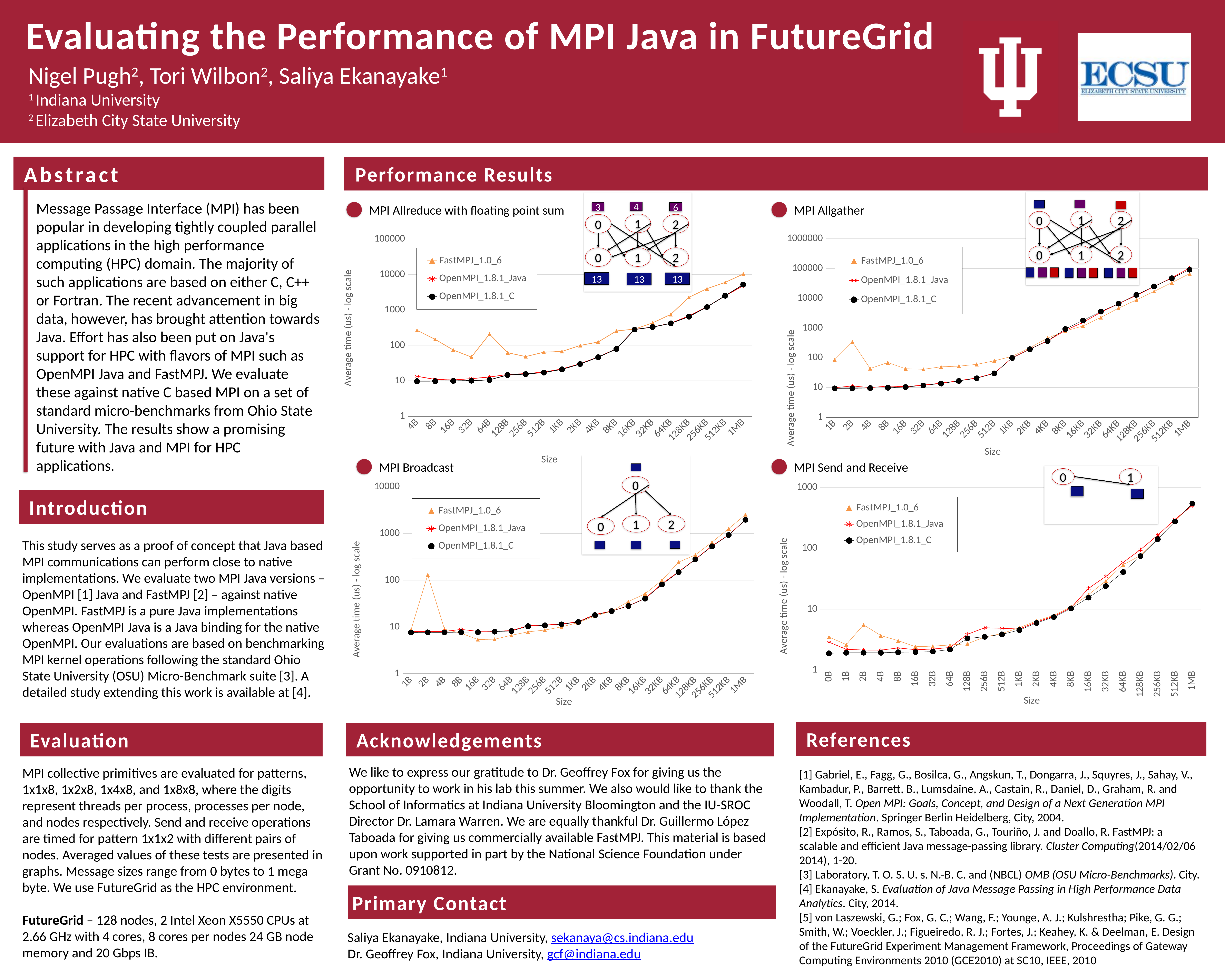
How many message sizes are shown on the x axis of the MPI Send and Receive chart? 22 How many message sizes are shown on the x axis of the MPI Allreduce with floating point sum chart? 19 In the MPI Send and Receive chart, what are the three series named in the legend? FastMPJ_1.0_6, OpenMPI_1.8.1_Java, OpenMPI_1.8.1_C In the MPI Allgather chart, do the OpenMPI_1.8.1_C values generally rise or fall as message size increases from 1KB to 1MB? rise What kind of chart is the MPI Allreduce with floating point sum chart? line chart In the MPI Allreduce with floating point sum chart, which series has the larger value at 4B, FastMPJ_1.0_6 or OpenMPI_1.8.1_C? FastMPJ_1.0_6 In the MPI Allreduce with floating point sum chart, is the value for FastMPJ_1.0_6 at 4B greater or less than 100? greater In the MPI Broadcast chart, is the value for FastMPJ_1.0_6 at 2B greater or less than 100? greater How many series does the legend of the MPI Broadcast chart list? 3 What is the y-axis label of the MPI Broadcast chart? Average time (us) - log scale How many message sizes are shown on the x axis of the MPI Allgather chart? 21 In the MPI Send and Receive chart, is the value for OpenMPI_1.8.1_C at 1MB greater or less than 100? greater